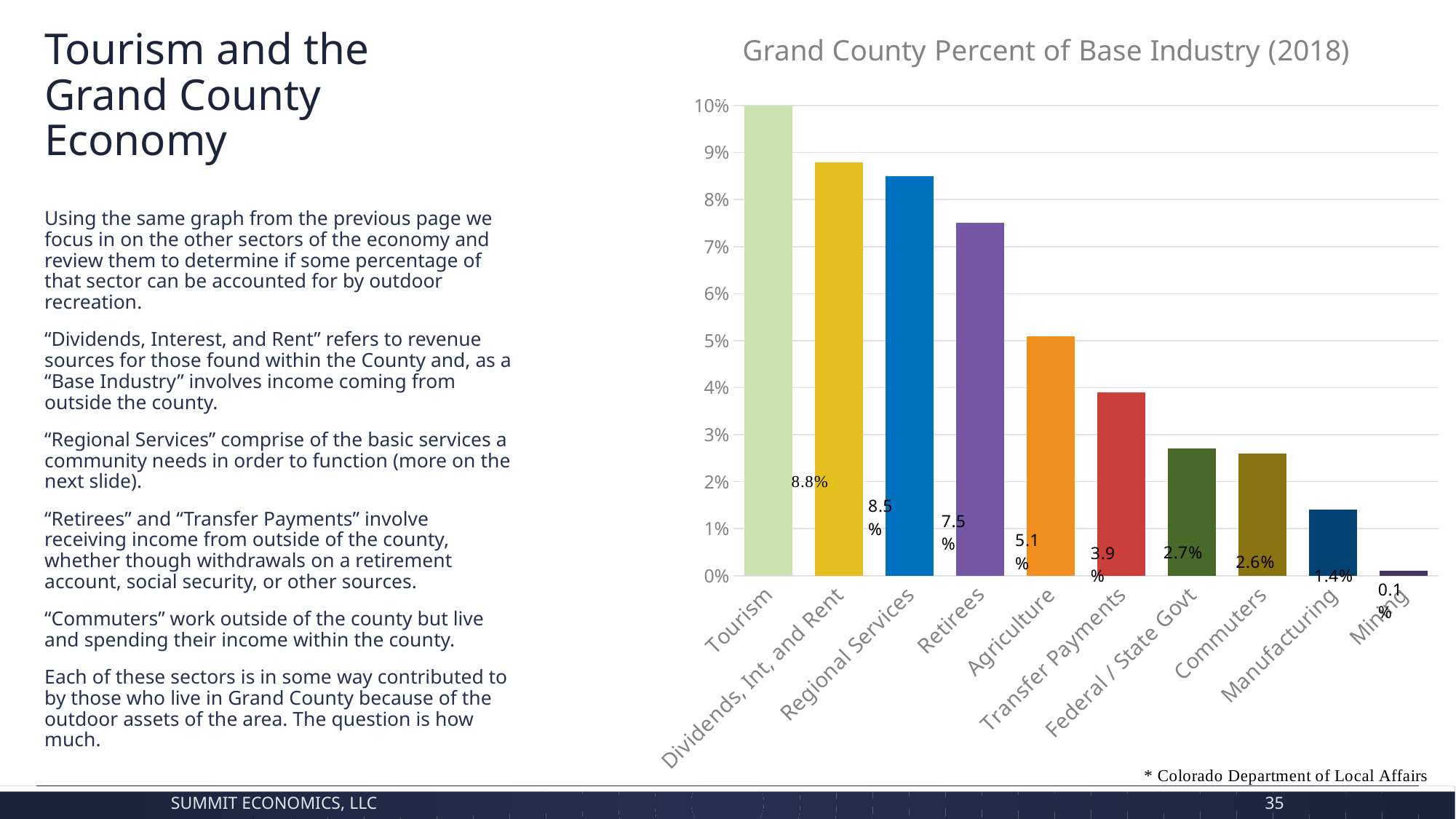
Which is larger, the value for Agriculture or the value for Transfer Payments? Agriculture What is the value for Dividends, Int, and Rent in the Grand County Percent of Base Industry (2018) chart? 8.8% What is the value for Manufacturing? 1.4% What is the difference between the values for Retirees and Agriculture? 2.4% Is the value for Tourism greater or less than 9%? greater What percent of base industry is shown for Retirees? 7.5% What is the difference between the values for Dividends, Int, and Rent and Regional Services? 0.3% How many categories are shown on the x axis of the chart? 10 What kind of chart is shown on the slide? Bar chart Which category has the highest value in the chart? Tourism Which category has the lowest value in the chart? Mining What is the value for Transfer Payments? 3.9%